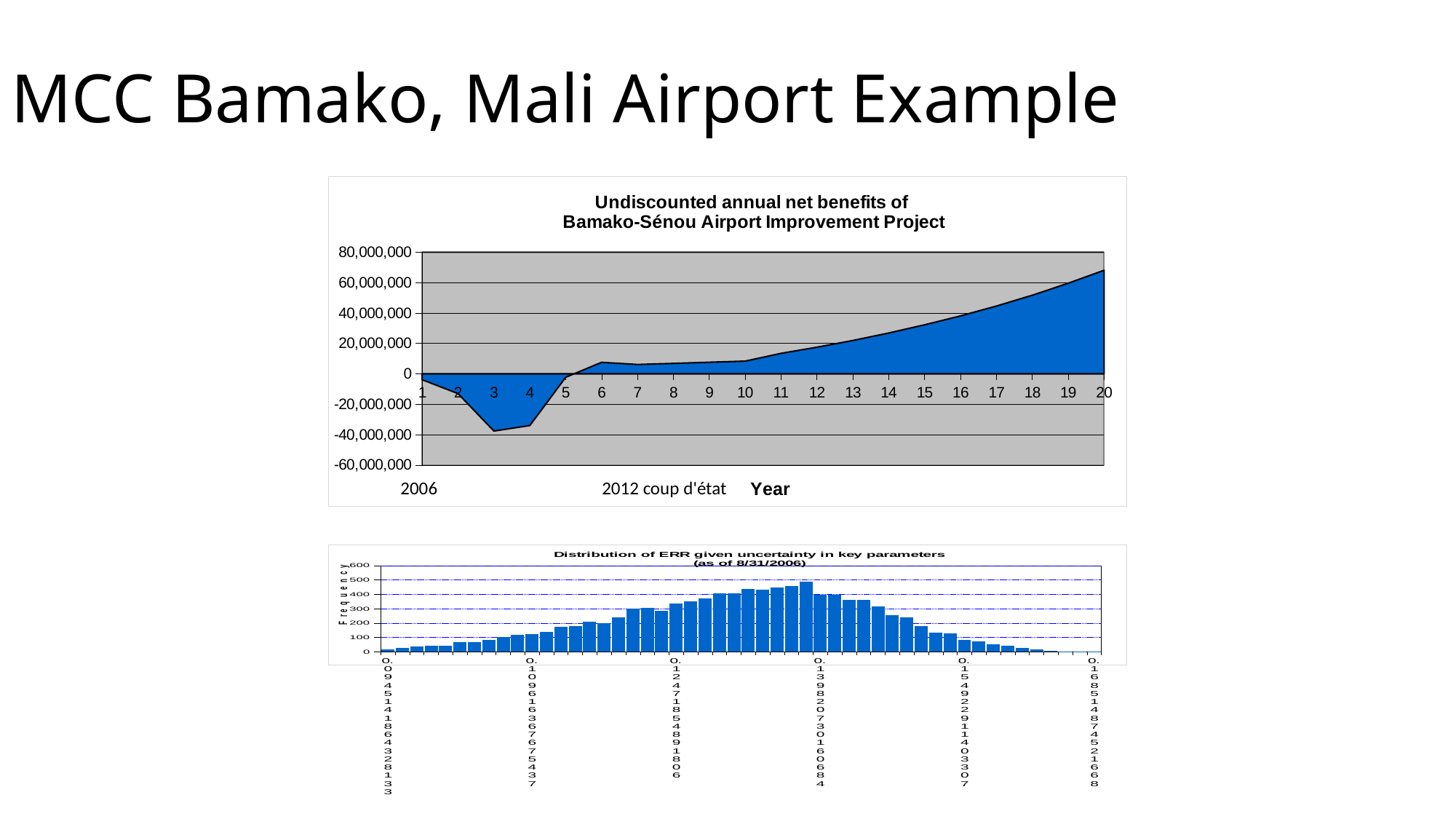
In the top chart (undiscounted annual net benefits), do the values rise or fall from year 5 to year 20? rise What kind of chart is the bottom chart titled 'Distribution of ERR given uncertainty in key parameters'? bar chart In the top chart (undiscounted annual net benefits), which year has the lowest net benefit? 3 In the top chart (undiscounted annual net benefits), which year has the highest net benefit? 20 In the top chart (undiscounted annual net benefits), is the value for year 3 greater or less than -20,000,000? less In the top chart (undiscounted annual net benefits), is the value for year 10 greater or less than 20,000,000? less What is the x-axis title of the top chart (undiscounted annual net benefits)? Year In the top chart (undiscounted annual net benefits), is the value for year 20 greater or less than 60,000,000? greater What kind of chart is the top chart titled 'Undiscounted annual net benefits of Bamako-Sénou Airport Improvement Project'? area chart In the top chart (undiscounted annual net benefits), how many years are plotted along the x axis? 20 In the top chart (undiscounted annual net benefits), which year has the larger net benefit, year 15 or year 8? 15